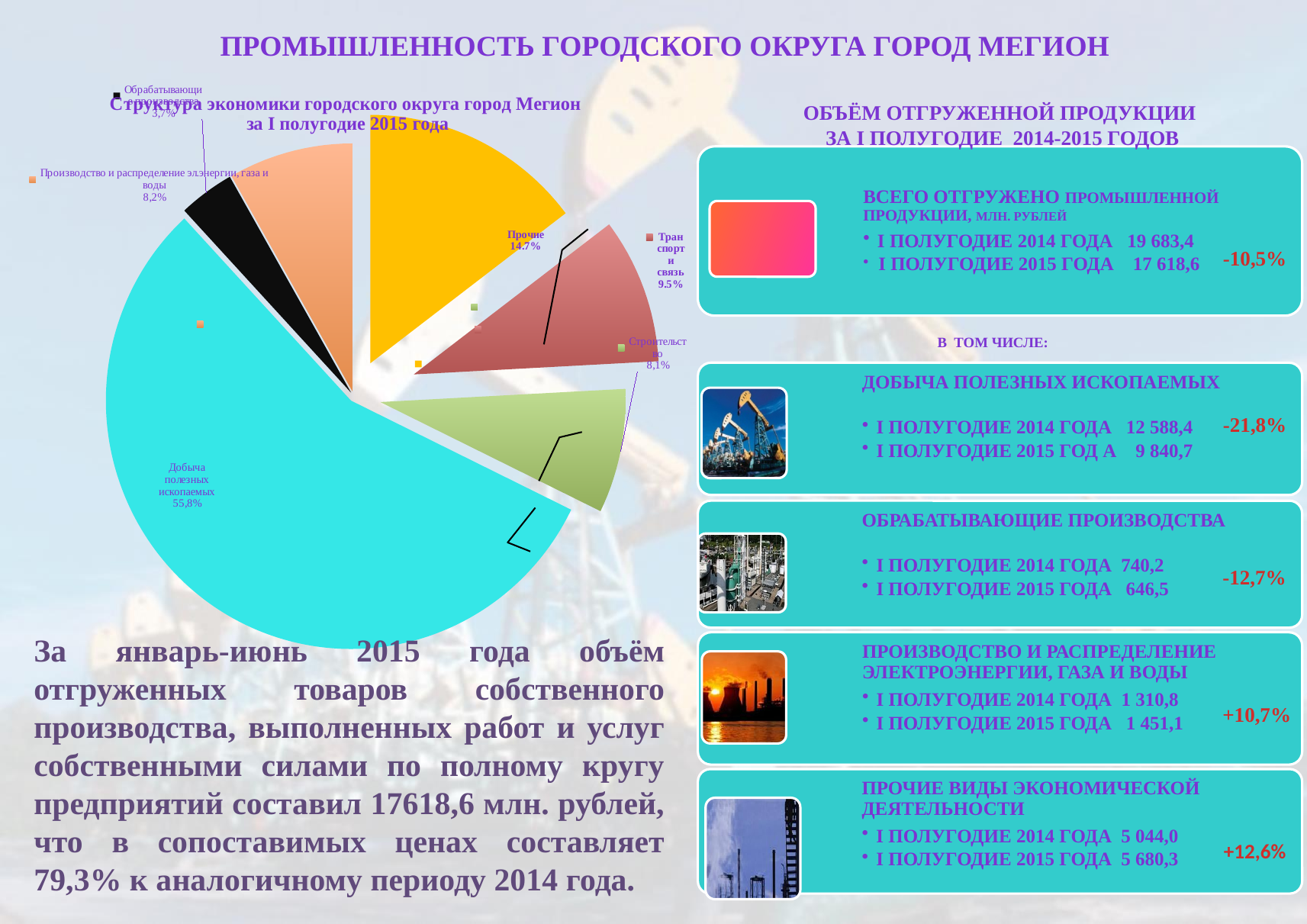
What kind of chart is shown on the left of the slide? pie chart Which category has the largest share in the pie chart? Добыча полезных ископаемых In the pie chart, which is larger: Транспорт и связь or Строительство? Транспорт и связь What is the title of the pie chart on the left of the slide? Структура экономики городского округа город Мегион за I полугодие 2015 года Which category has the smallest share in the pie chart? Обрабатывающие производства How many slices does the pie chart have? 6 What is the value shown for Прочие in the pie chart? 14.7% What is the value shown for Транспорт и связь in the pie chart? 9.5% What is the value shown for Строительство in the pie chart? 8,1% What is the value shown for Производство и распределение элэнергии, газа и воды in the pie chart? 8,2% What share of the pie chart does Добыча полезных ископаемых account for? 55,8% In the pie chart, what is the difference between the shares of Добыча полезных ископаемых and Прочие? 41,1%